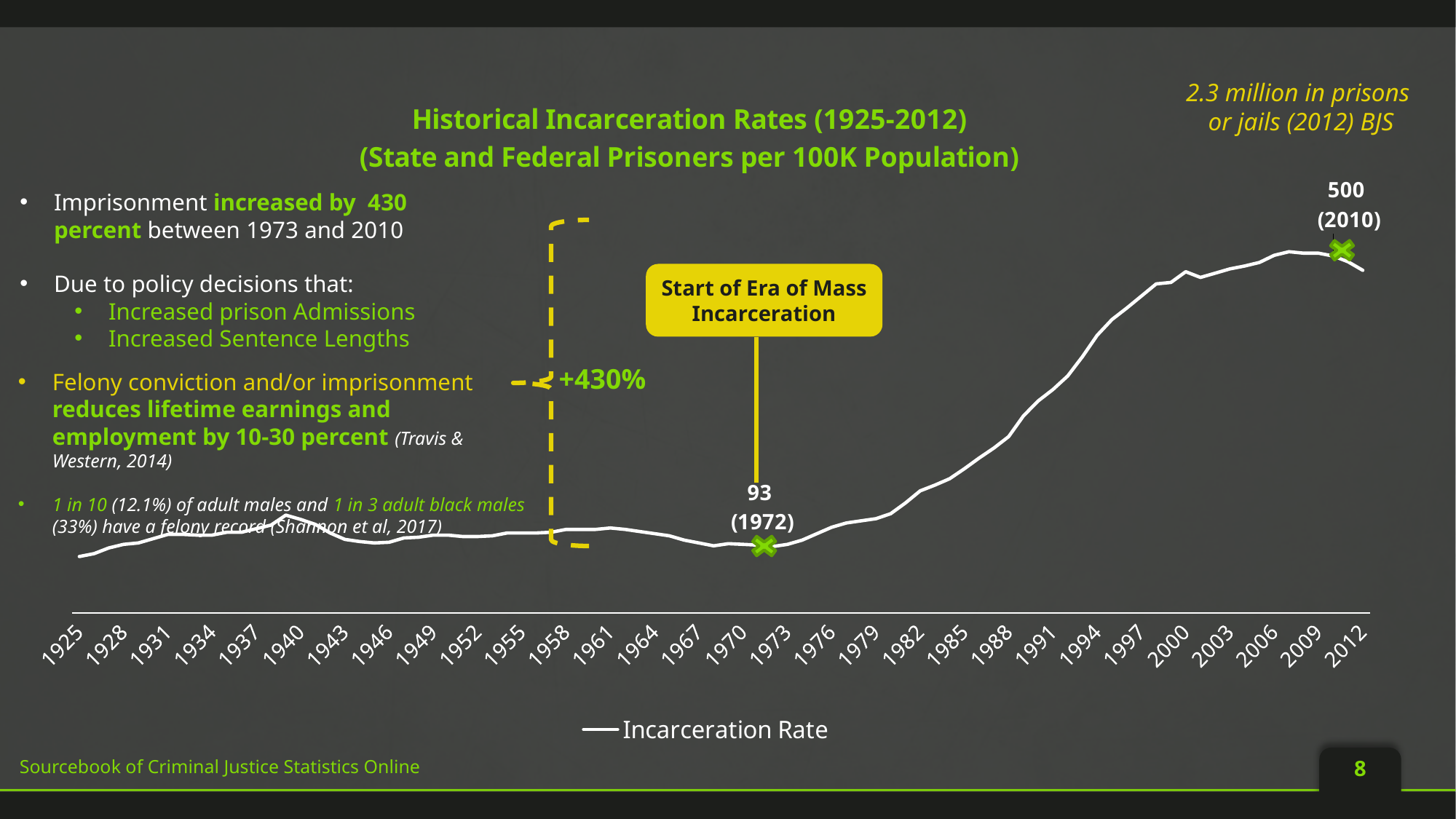
How many year labels are shown on the x axis? 30 What is the first year shown on the x axis of the chart? 1925 What is the labeled incarceration rate for 2010? 500 Which labeled point has the higher incarceration rate, 1972 or 2010? 2010 Which year is marked on the chart as the 'Start of Era of Mass Incarceration'? 1972 How many series does the chart legend list? 1 What kind of chart is shown on the slide? Line chart Does the incarceration rate rise or fall between 2009 and 2012? Fall What is the difference between the labeled values for 2010 and 1972? 407 What is the name of the series shown in the legend? Incarceration Rate What is the labeled incarceration rate for 1972? 93 Does the incarceration rate rise or fall between 1973 and 2010? Rise